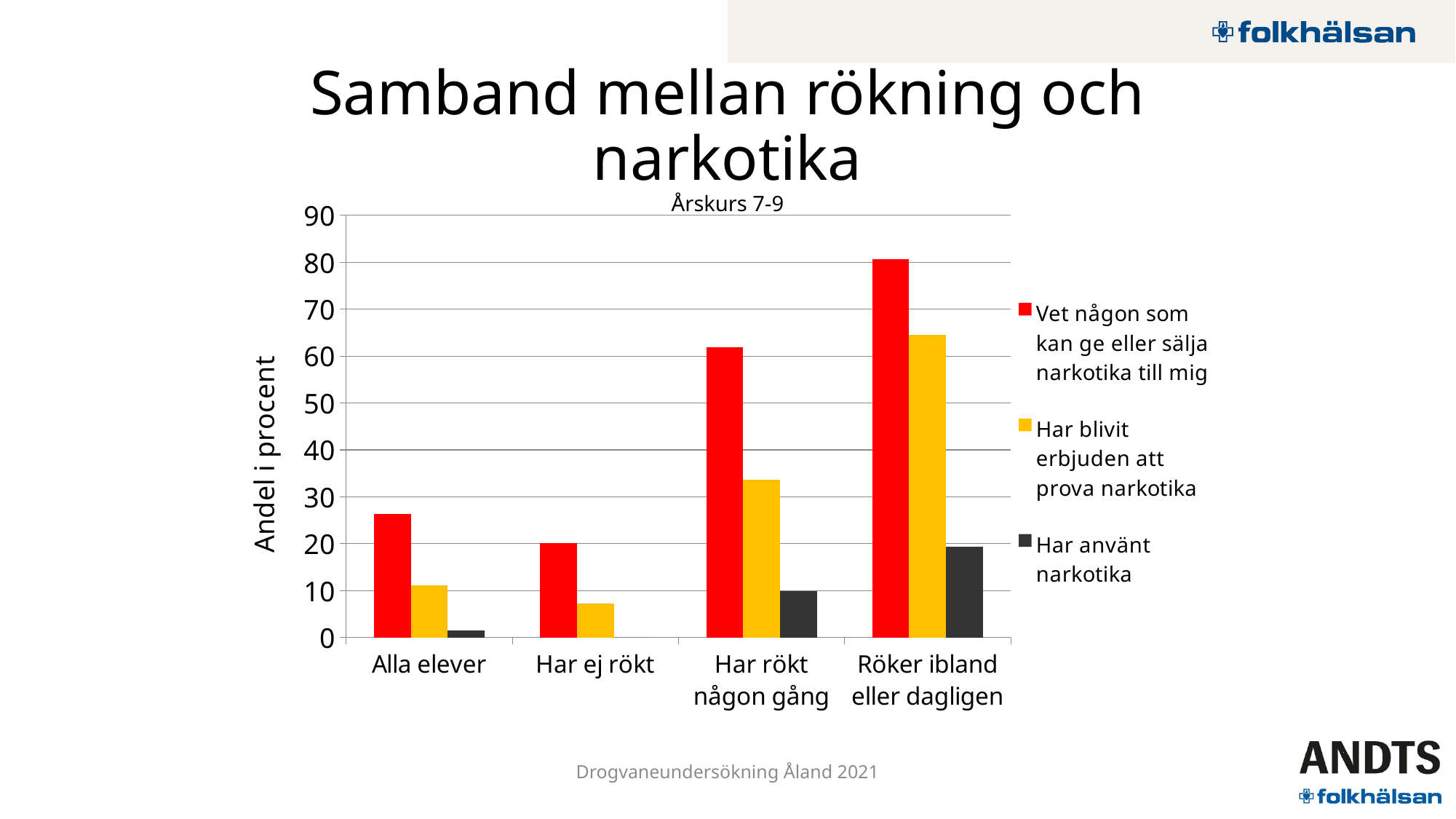
Do the values for 'Vet någon som kan ge eller sälja narkotika till mig' rise or fall from 'Har ej rökt' to 'Röker ibland eller dagligen'? rise What is the label on the vertical axis of the chart? Andel i procent Which is larger: 'Har blivit erbjuden att prova narkotika' for 'Har rökt någon gång' or for 'Alla elever'? Har rökt någon gång Which category has the lowest value for 'Vet någon som kan ge eller sälja narkotika till mig'? Har ej rökt Is the value for 'Har blivit erbjuden att prova narkotika' in the 'Röker ibland eller dagligen' category greater or less than 60? greater Is the value for 'Vet någon som kan ge eller sälja narkotika till mig' in the 'Röker ibland eller dagligen' category greater or less than 70? greater Is the value for 'Har blivit erbjuden att prova narkotika' in the 'Alla elever' category greater or less than 20? less How many categories are shown on the x axis? 4 Which category has the highest value for 'Vet någon som kan ge eller sälja narkotika till mig'? Röker ibland eller dagligen How many series does the legend list? 3 Which category has the lowest value for 'Har använt narkotika'? Har ej rökt What kind of chart is shown on the slide? bar chart